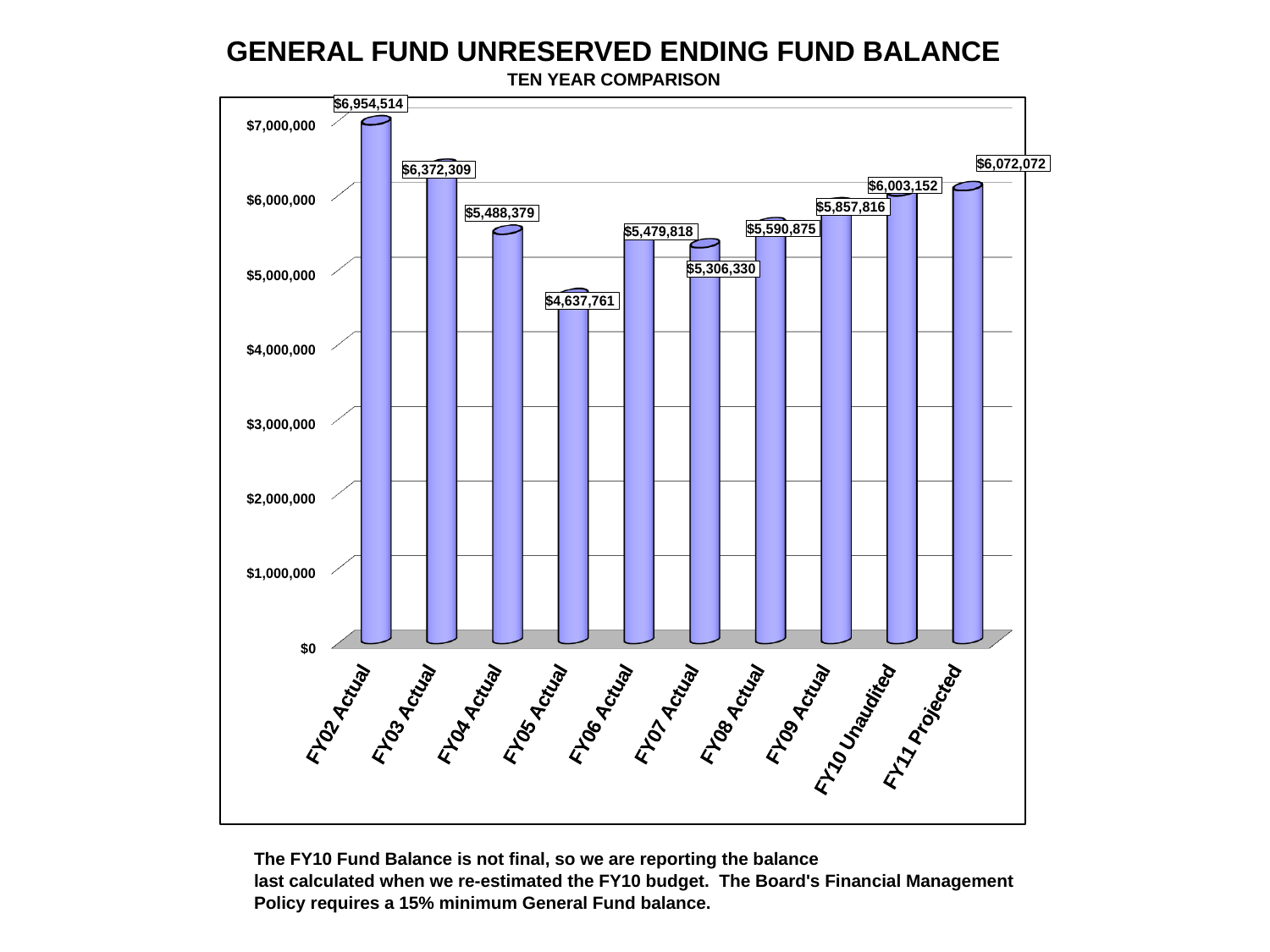
What is the value for FY11 Projected? $6,072,072 How many fiscal years are shown on the chart? 10 What is the difference between the FY11 Projected and FY10 Unaudited values? $68,920 Which fiscal year has the highest ending fund balance? FY02 Actual What is the value for FY05 Actual? $4,637,761 What is the difference between the FY02 Actual and FY05 Actual values? $2,316,753 Which fiscal year has the lowest ending fund balance? FY05 Actual What is the value for FY02 Actual? $6,954,514 What kind of chart is shown on the slide? Bar chart Do the values rise or fall from FY07 Actual to FY11 Projected? Rise Which is larger, the value for FY06 Actual or FY07 Actual? FY06 Actual What is the value for FY10 Unaudited? $6,003,152